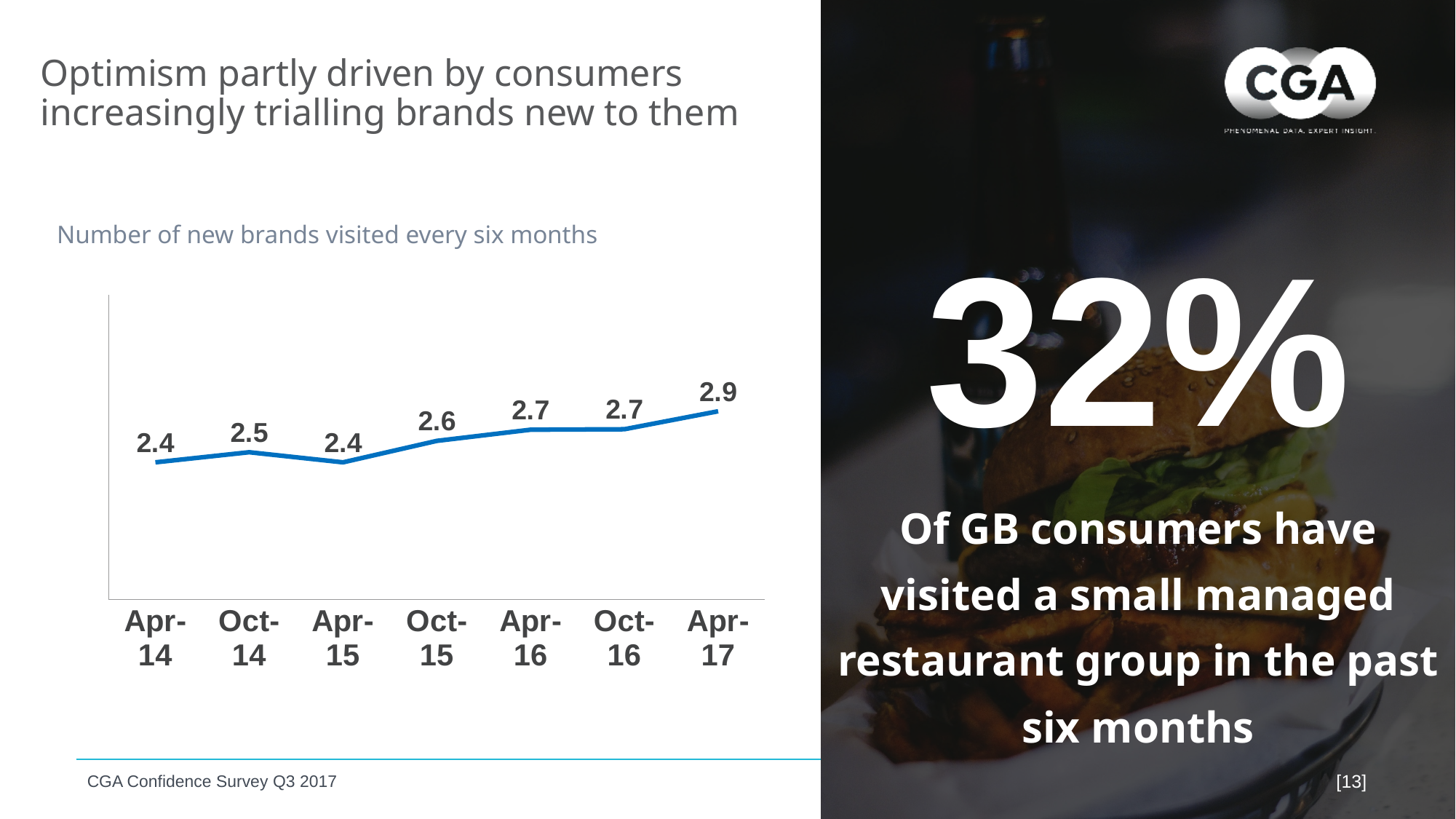
What is the value for Oct-16? 2.7 Which period has the highest number of new brands visited? Apr-17 What is the value for Oct-15? 2.6 What is the difference between the values for Oct-14 and Apr-15? 0.1 What is the title of the chart? Number of new brands visited every six months How many time periods are plotted on the chart? 7 What is the number of new brands visited every six months for Apr-17? 2.9 What is the value for Apr-14? 2.4 Which is larger, the value for Oct-14 or the value for Apr-15? Oct-14 What kind of chart is shown on the slide? Line chart What is the difference between the values for Apr-17 and Apr-14? 0.5 Do the values generally rise or fall from Apr-14 to Apr-17? Rise